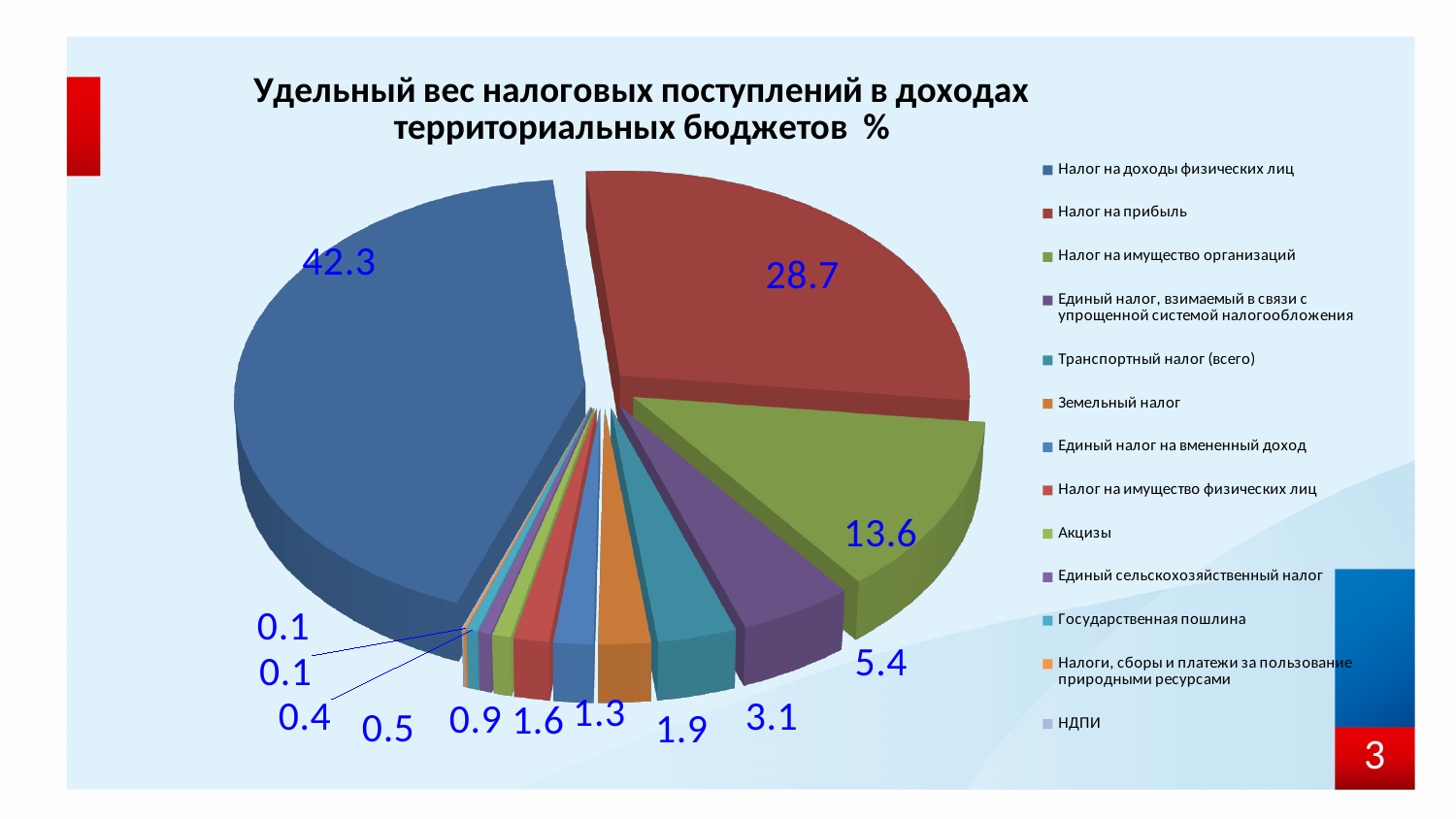
What is the value for Налог на доходы физических лиц? 42.3 What is the title of the chart? Удельный вес налоговых поступлений в доходах территориальных бюджетов % What is the value for Налог на прибыль? 28.7 Which is larger, Налог на имущество организаций or Транспортный налог (всего)? Налог на имущество организаций Which category has the largest share of the pie? Налог на доходы физических лиц What is the value for Транспортный налог (всего)? 3.1 What type of chart is shown on the slide? pie chart What is the smallest value shown on the pie chart? 0.1 What is the value for Единый налог, взимаемый в связи с упрощенной системой налогообложения? 5.4 How many categories does the legend list? 13 What is the difference between the values for Налог на доходы физических лиц and Налог на прибыль? 13.6 What is the value for Налог на имущество организаций? 13.6